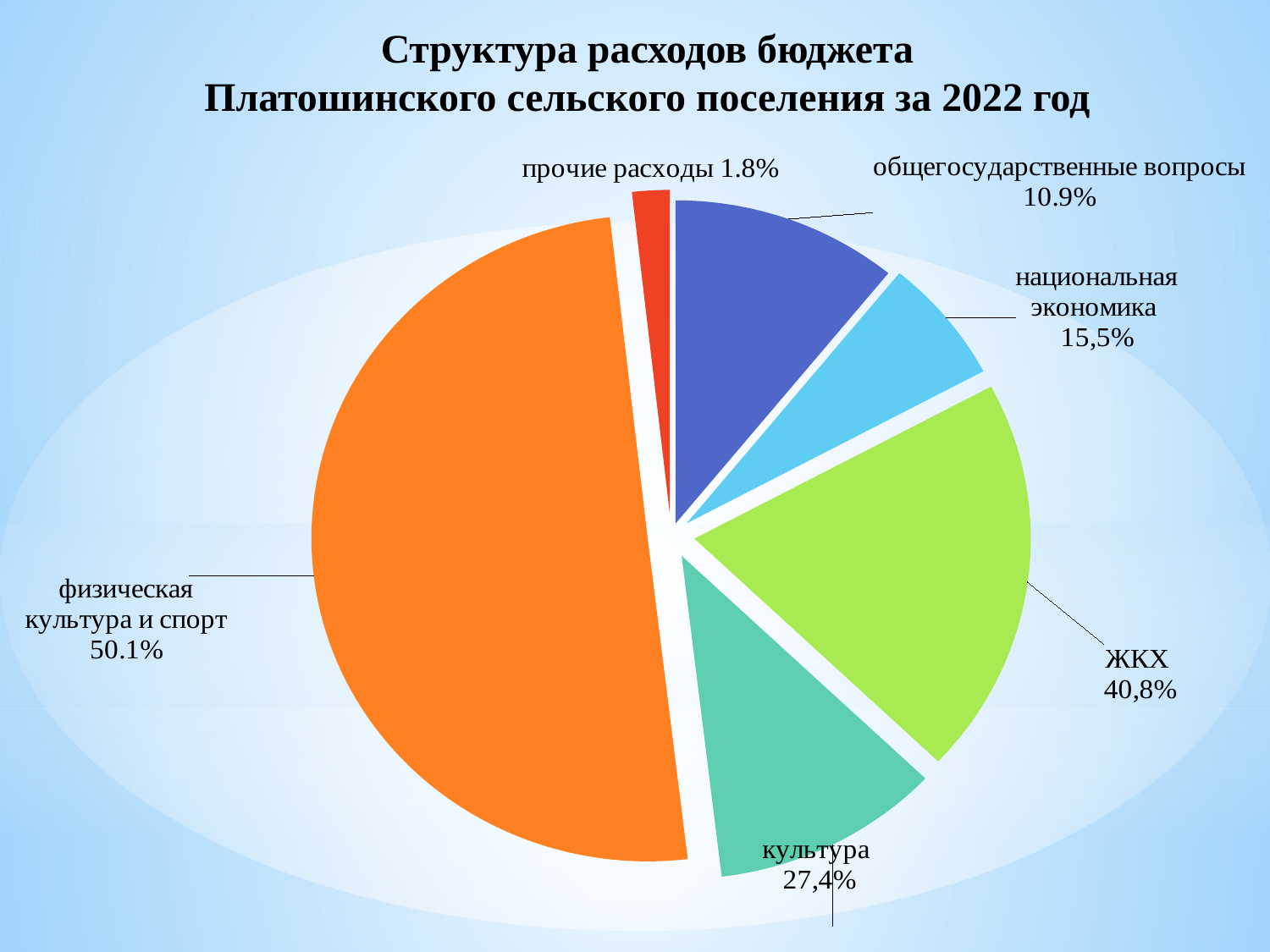
What percentage is shown for национальная экономика? 15,5% What percentage is shown for прочие расходы? 1.8% What year does the chart title say the budget expenditure structure refers to? 2022 What percentage is shown for физическая культура и спорт? 50.1% Which category has the largest slice of the pie? физическая культура и спорт What percentage is shown for общегосударственные вопросы? 10.9% What kind of chart is shown on the slide? pie chart Which category has the smallest slice of the pie? прочие расходы Which is larger, the slice for ЖКХ or the slice for культура? ЖКХ What percentage is shown for культура? 27,4% What percentage is shown for ЖКХ? 40,8% How many slices does the pie chart have? 6